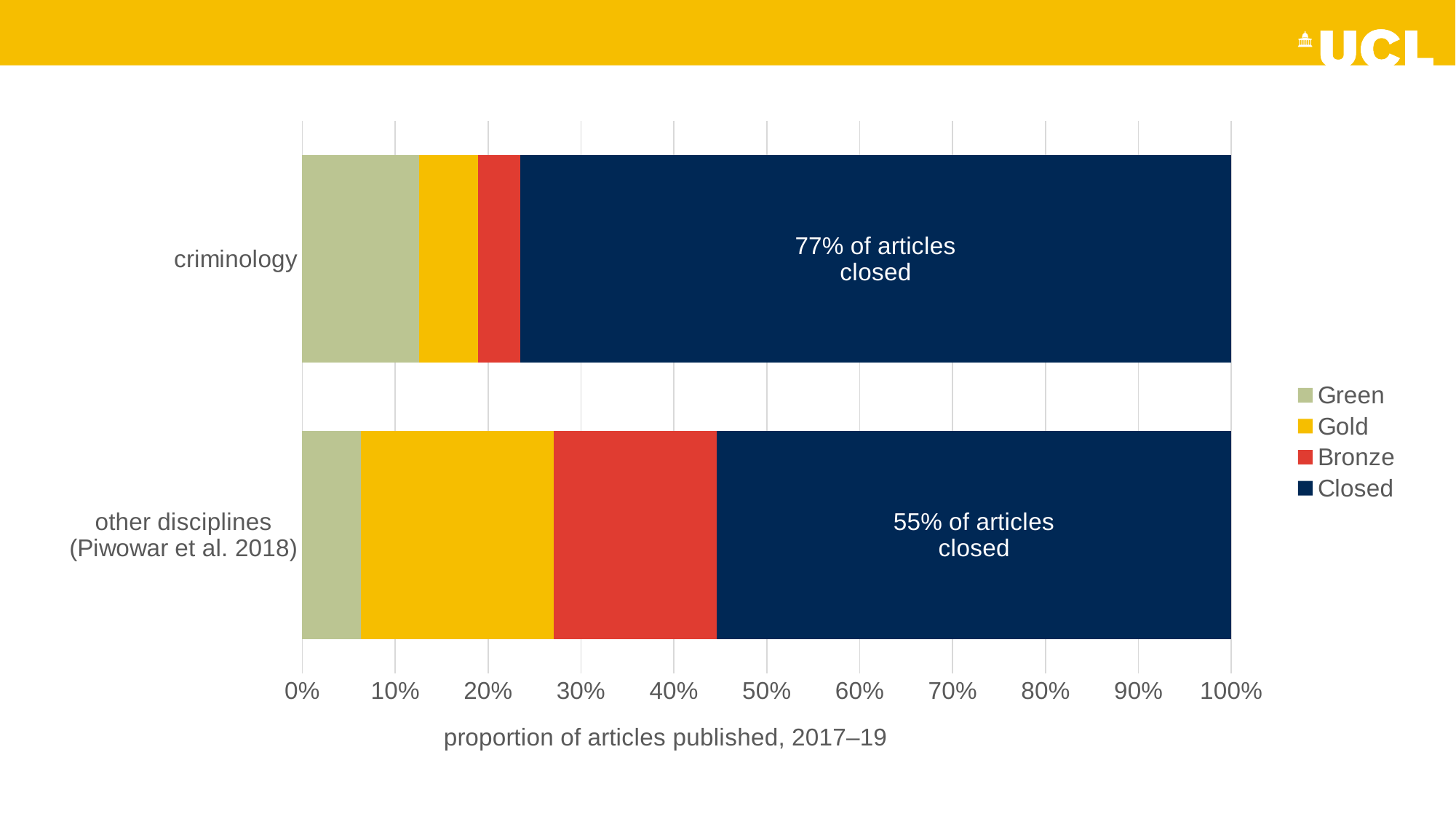
What kind of chart is shown on the slide? stacked bar chart Which category has the larger Gold segment, criminology or other disciplines? other disciplines How many series does the legend list? 4 Is the Green share for criminology greater or less than 10%? greater Which category has the larger proportion of closed articles, criminology or other disciplines? criminology What proportion of articles in other disciplines (Piwowar et al. 2018) are closed? 55% What is the difference in percentage points between the closed share for criminology and for other disciplines? 22 percentage points What is the title of the horizontal axis? proportion of articles published, 2017–19 How many categories (bars) are shown on the chart? 2 What are the entries listed in the legend? Green, Gold, Bronze, Closed Is the Green share for other disciplines greater or less than 10%? less What proportion of criminology articles are closed? 77%